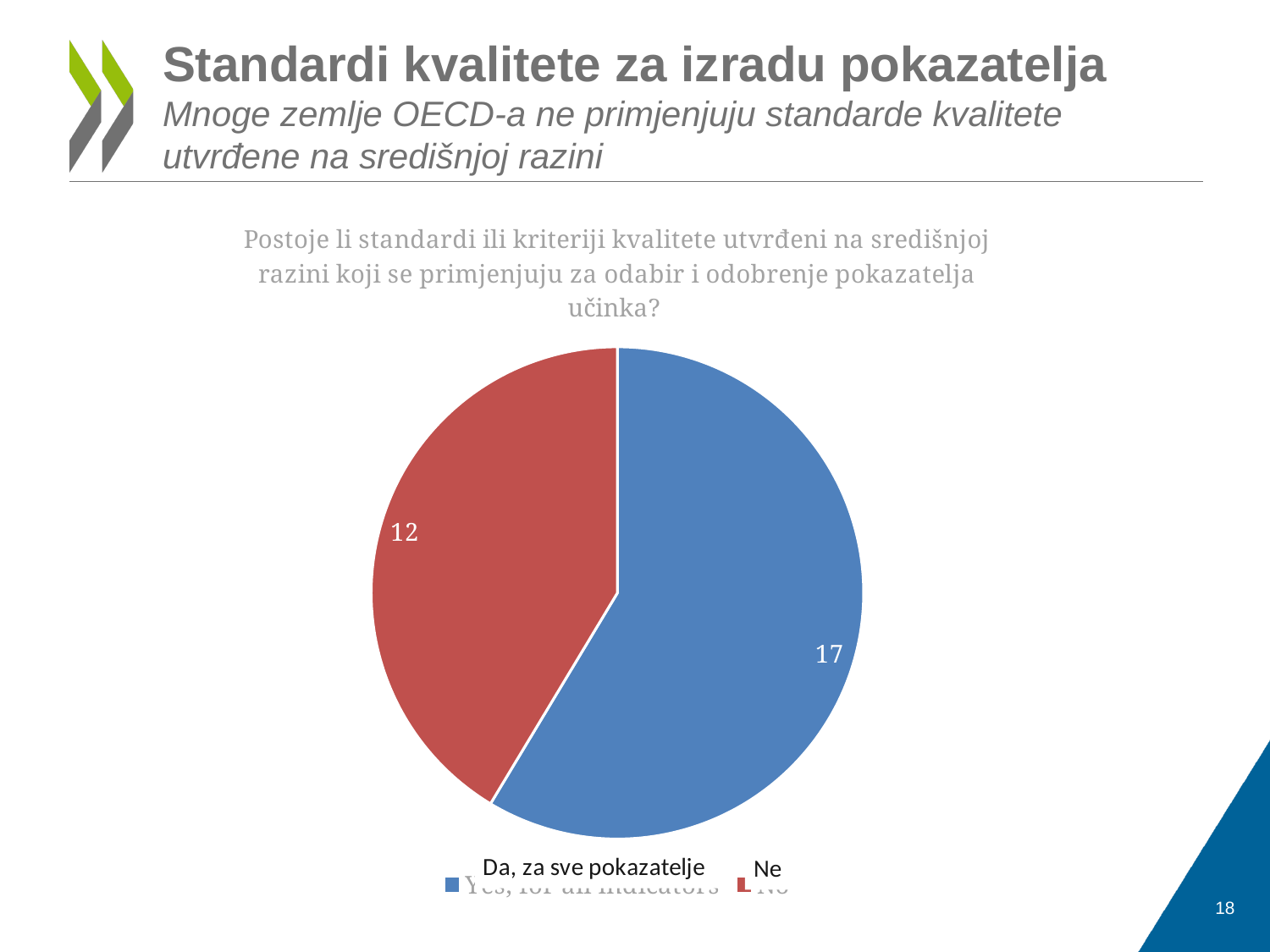
Which slice is the largest? Da, za sve pokazatelje What is the difference between the 'Da, za sve pokazatelje' and 'Ne' values? 5 What colour is the 'Da, za sve pokazatelje' slice? blue Which is larger, the 'Da, za sve pokazatelje' slice or the 'Ne' slice? Da, za sve pokazatelje What fraction of the total does the 'Ne' slice represent? 12 out of 29 How many slices does the pie chart have? 2 What is the value for the 'Da, za sve pokazatelje' slice? 17 What is the value for the 'Ne' slice? 12 What colour is the 'Ne' slice? red What kind of chart is shown on the slide? pie chart Which slice is the smallest? Ne What is the total of all slices in the pie chart? 29